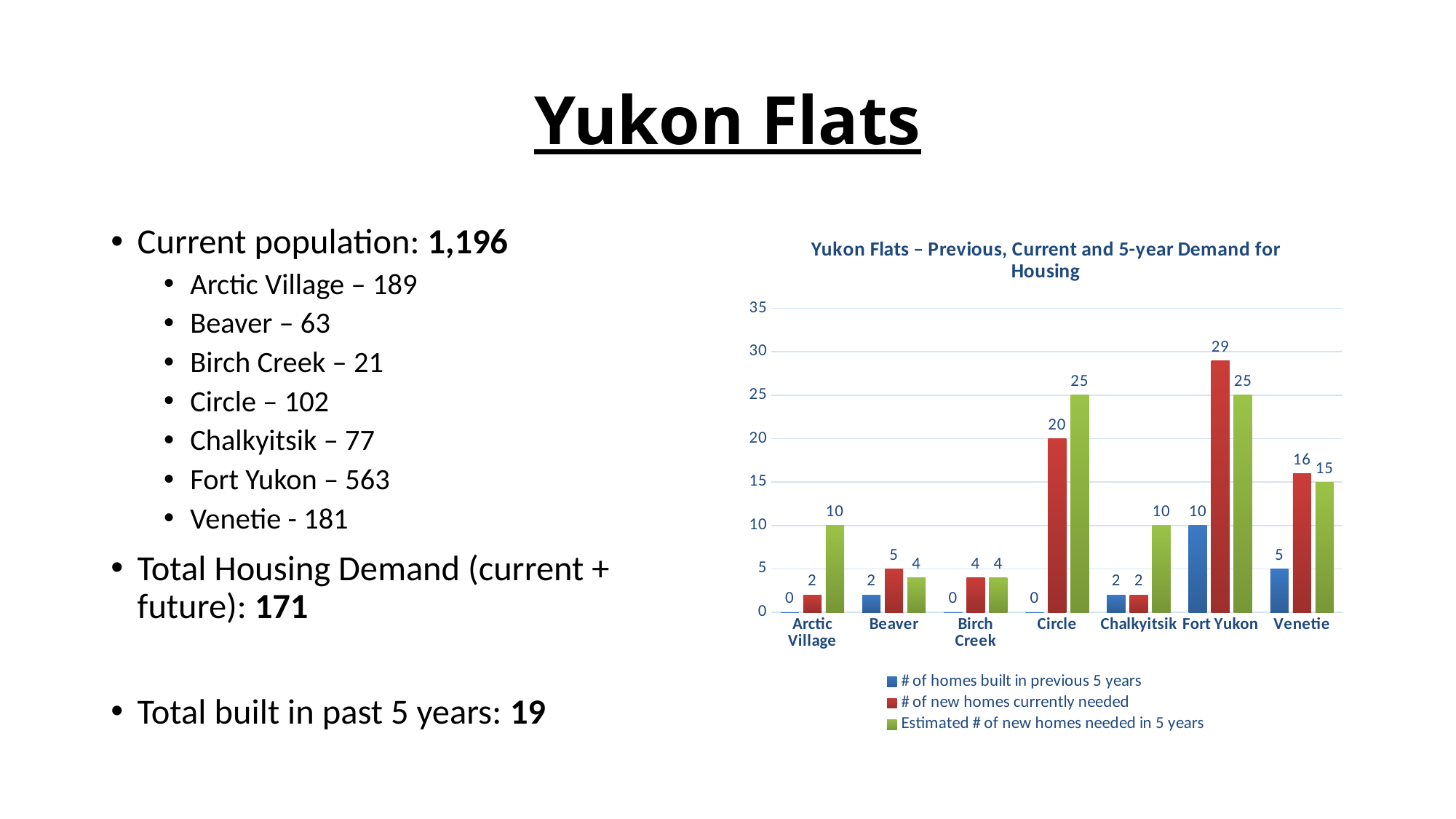
How many series does the chart legend list? 3 What kind of chart is shown on the slide? Bar chart Which colour represents the estimated number of new homes needed in 5 years? Green How many homes were built in the previous 5 years in Venetie? 5 What is the number of new homes currently needed in Fort Yukon? 29 What is the title of the chart? Yukon Flats – Previous, Current and 5-year Demand for Housing Which is larger: the estimated number of new homes needed in 5 years for Venetie or for Chalkyitsik? Venetie Which community has the highest number of homes built in the previous 5 years? Fort Yukon What is the difference between the number of new homes currently needed in Fort Yukon and in Circle? 9 What is the estimated number of new homes needed in 5 years for Circle? 25 How many communities are shown on the x axis of the chart? 7 Which community has the highest number of new homes currently needed? Fort Yukon